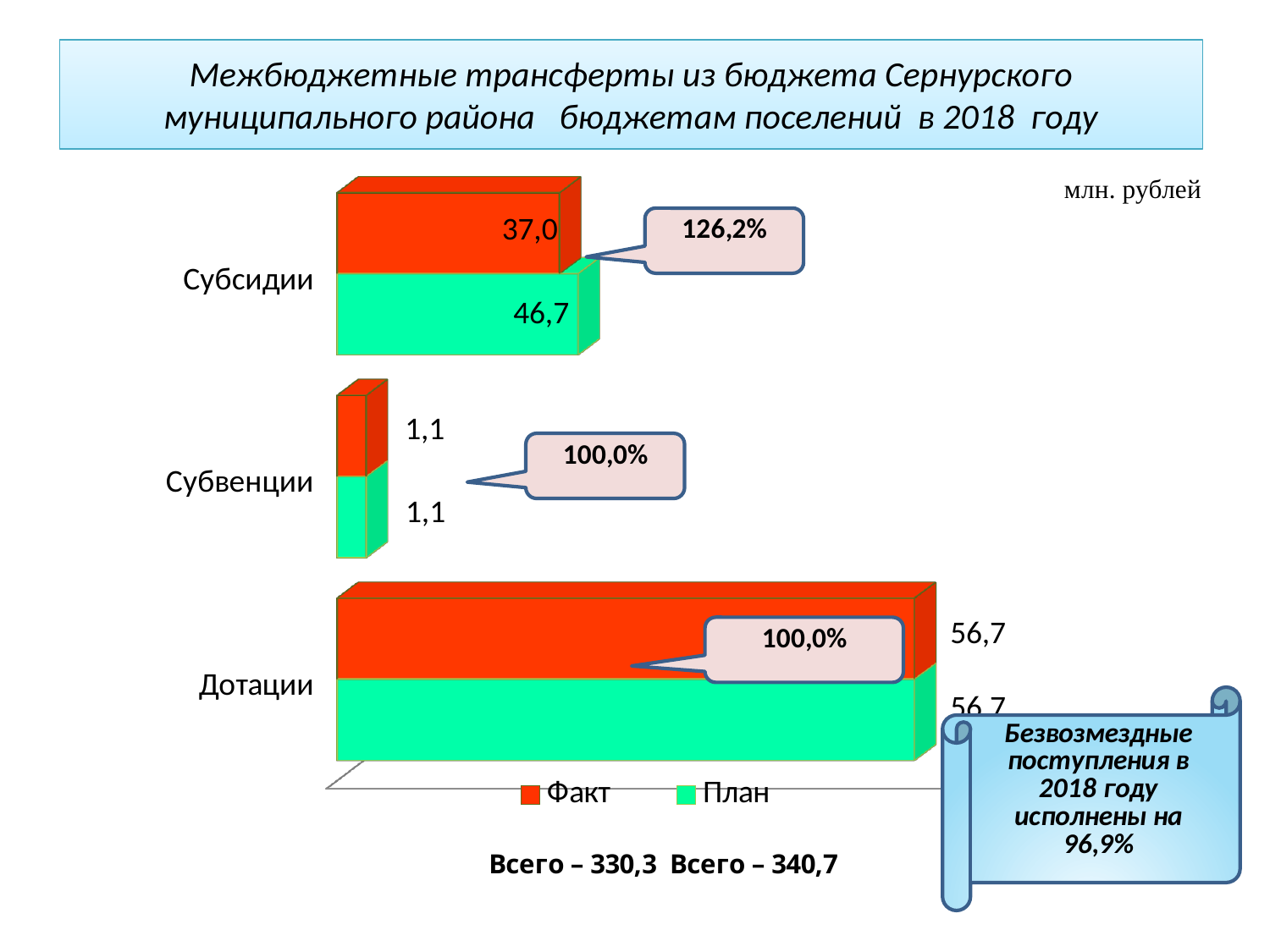
What percentage is shown in the callout next to the Субсидии bars? 126,2% What is the Факт value for Субсидии? 37,0 What is the Факт value for Дотации? 56,7 What is the План value for Субсидии? 46,7 What is the difference between the План and Факт values for Субсидии? 9,7 How many categories are shown in the chart? 3 How many series does the legend list? 2 What is the План value for Субвенции? 1,1 Which category has the highest Факт value? Дотации For Субсидии, which is larger: the Факт value or the План value? План What kind of chart is shown on the slide? Bar chart Which category has the lowest План value? Субвенции